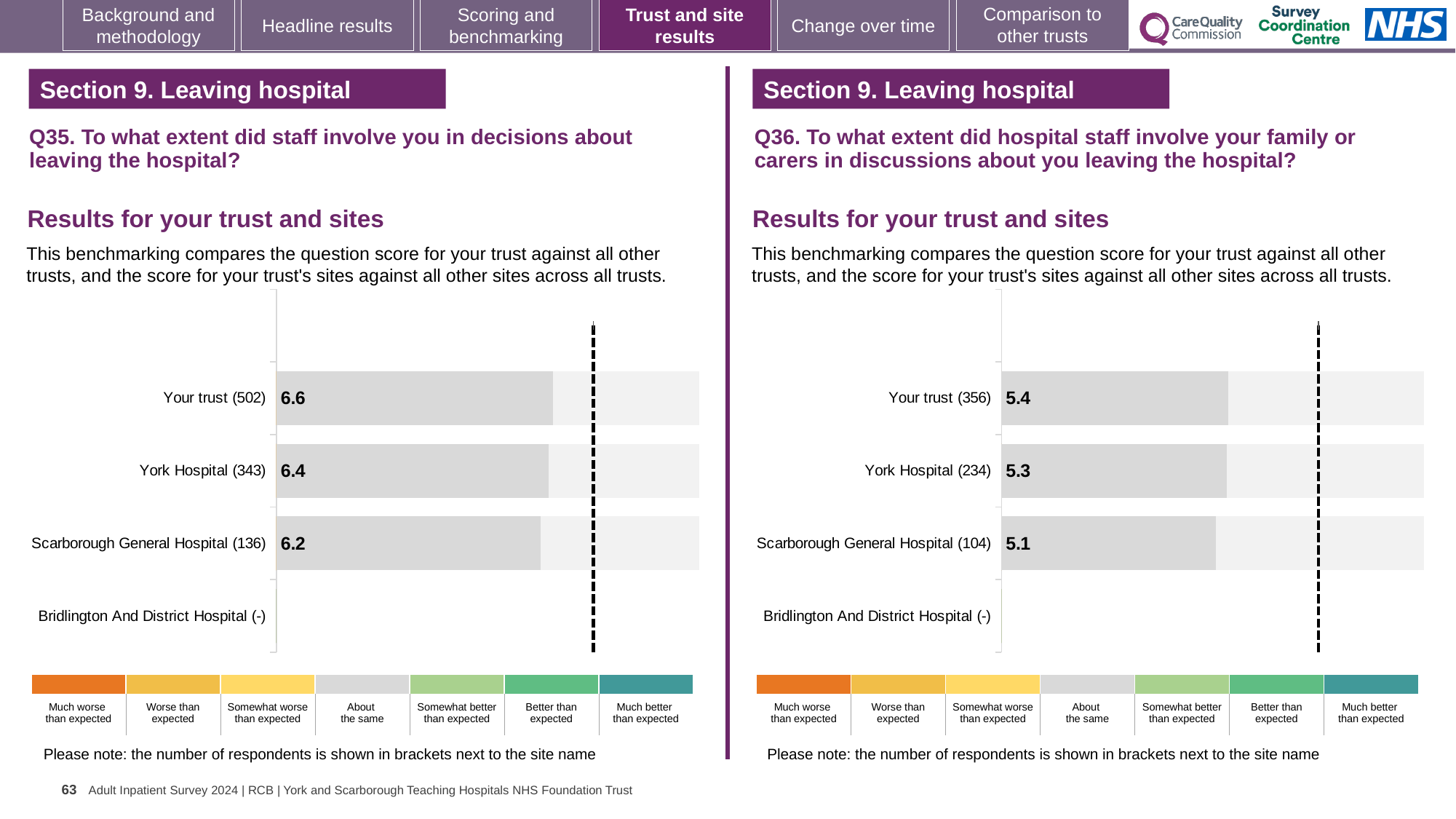
How many categories (trust and sites) are listed on the Q36 chart (right)? 4 On the Q35 chart (left), what is the difference between the scores for Your trust (502) and York Hospital (343)? 0.2 On the Q36 chart (right), which site or trust has the highest printed score? Your trust (356) On the Q36 chart (right), how many respondents are shown in brackets for Scarborough General Hospital? 104 What kind of chart is used on the Q35 chart (left)? Bar chart On the Q35 chart (left), what is the score for Scarborough General Hospital (136)? 6.2 On the Q36 chart (right), what is the difference between the scores for York Hospital (234) and Scarborough General Hospital (104)? 0.2 On the Q36 chart (right), what is the score for Your trust (356)? 5.4 On the Q35 chart (left), which has the larger score: York Hospital (343) or Scarborough General Hospital (136)? York Hospital (343) On the Q35 chart (left), which site or trust has the lowest printed score? Scarborough General Hospital (136) On the Q35 chart (left), what is the score for Your trust (502)? 6.6 On the Q36 chart (right), what is the score for York Hospital (234)? 5.3